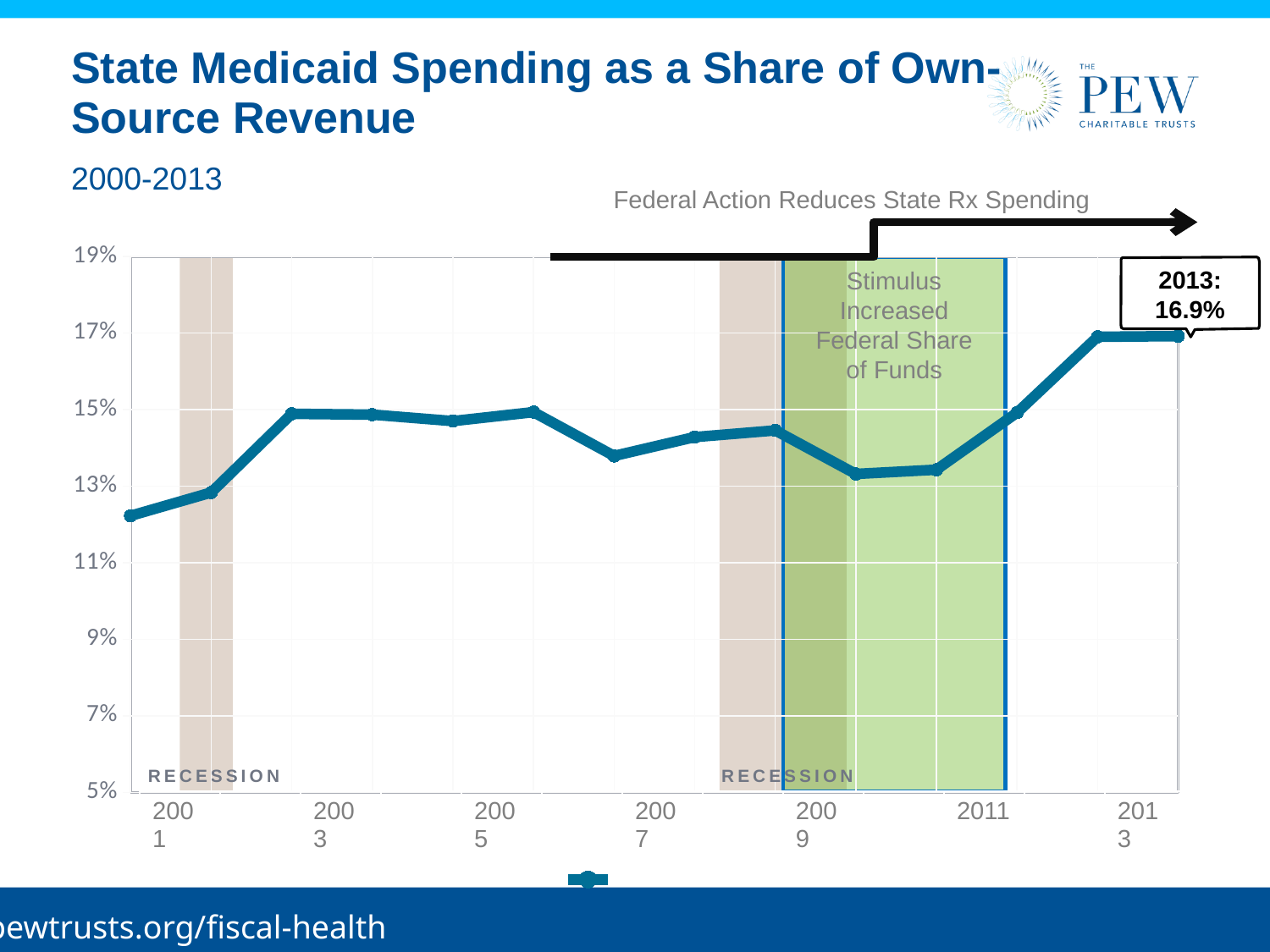
What period does the subtitle of the chart cover? 2000-2013 Is the value for 2000 greater or less than 13%? less Which year has the lowest value on the chart? 2000 Is the value for 2013 larger or smaller than the value for 2009? larger What kind of chart is shown on the slide? line chart Overall, does the line rise or fall from 2000 to 2013? rise Is the value for 2013 greater or less than 15%? greater Is the value for 2006 greater or less than 15%? less How many shaded areas labelled RECESSION appear on the chart? 2 What is the value for 2013 shown in the data label? 16.9% How many data points are plotted on the line? 14